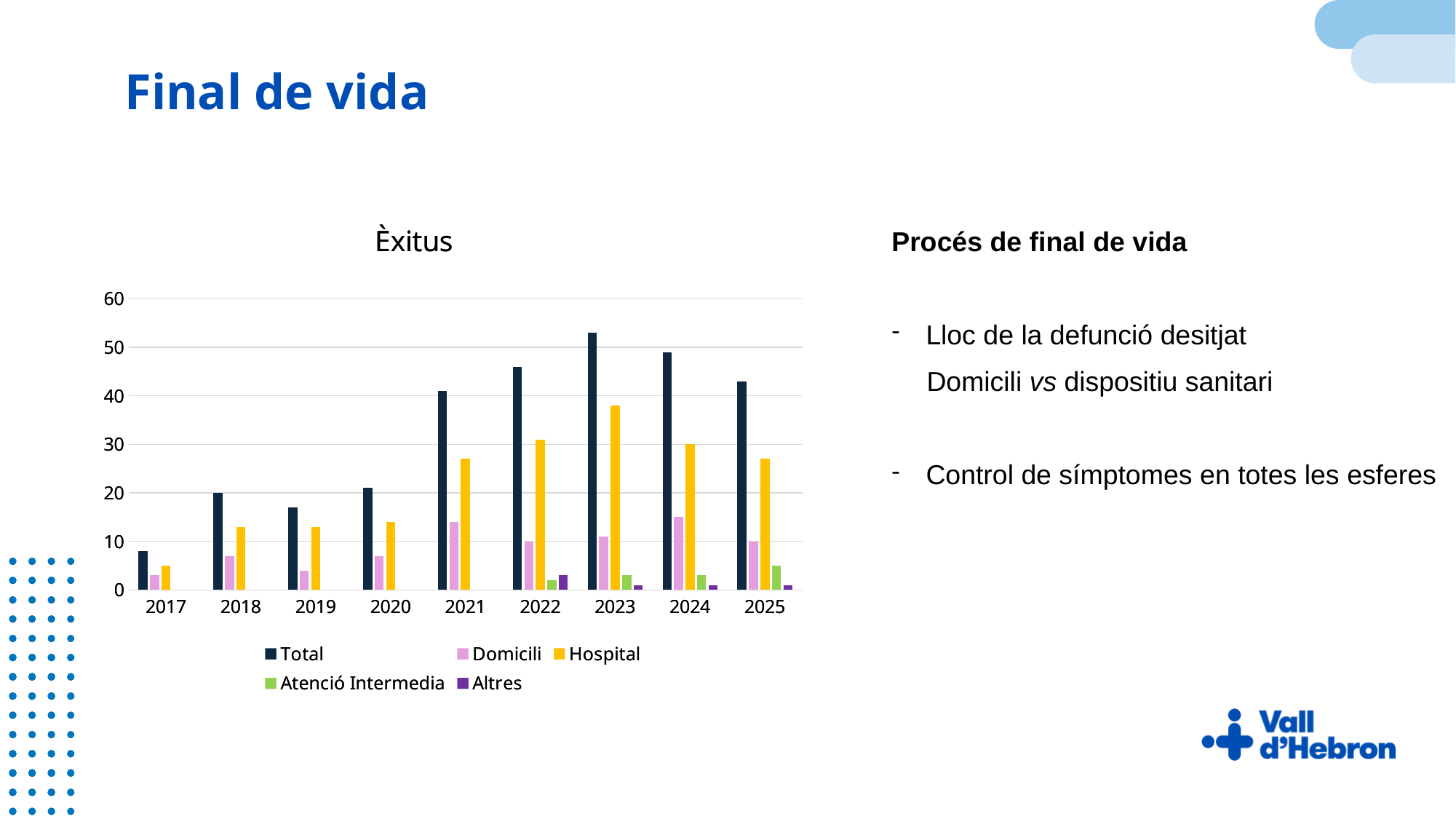
What is the title of the chart? Èxitus What kind of chart is shown on the slide? bar chart In which year is the Total series lowest? 2017 Is the Hospital value for 2023 greater or less than 30? greater Is the Total value for 2023 greater or less than 50? greater Which is larger: the Domicili value for 2024 or for 2022? 2024 How many years are shown on the x axis of the Èxitus chart? 9 How many series does the legend of the Èxitus chart list? 5 In which year is the Total series highest? 2023 Is the Hospital value for 2017 greater or less than 10? less Does the Total series rise or fall from 2017 to 2021? rise In 2023, which is larger: Hospital or Domicili? Hospital